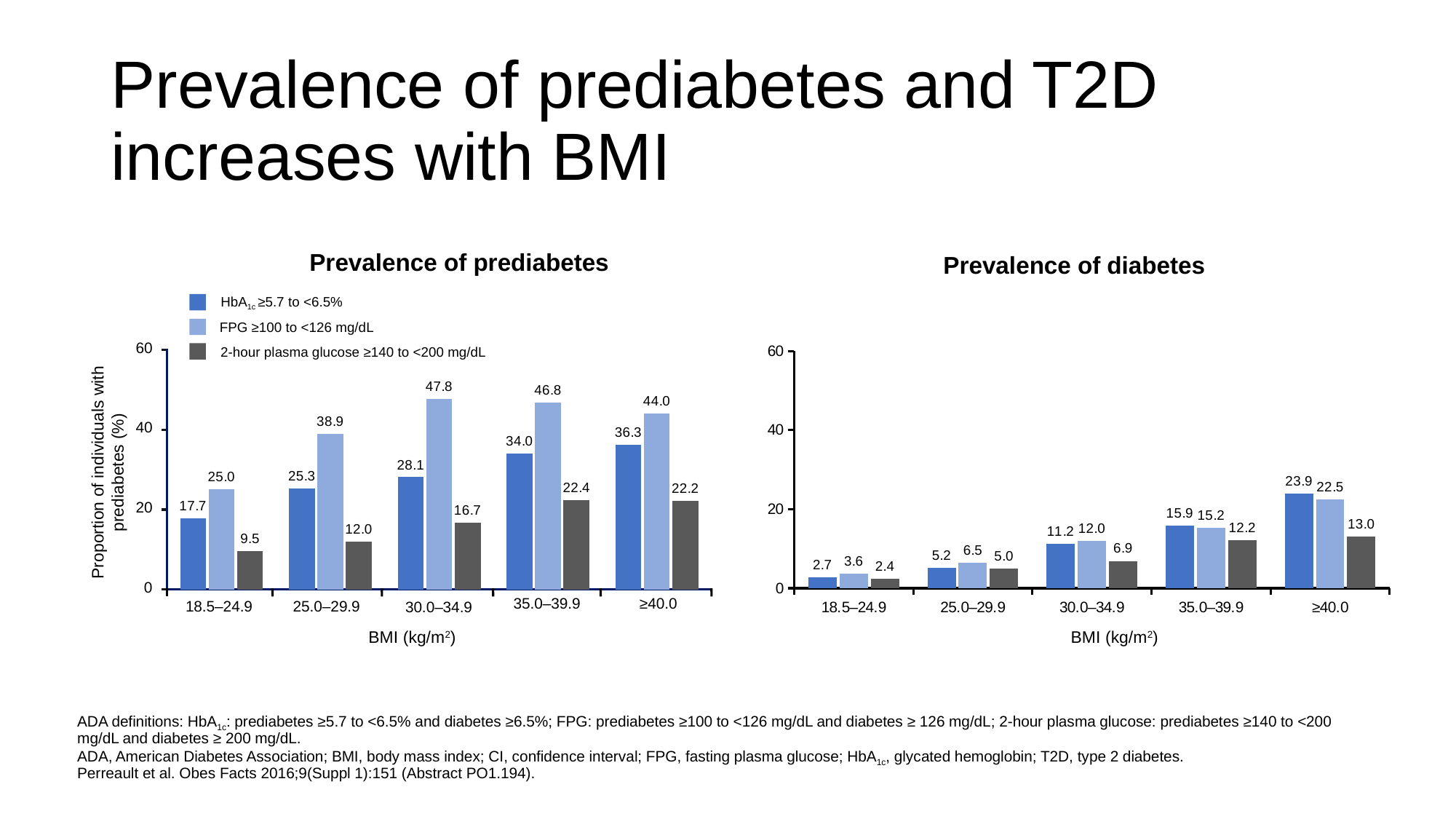
In the 'Prevalence of diabetes' chart, what is the value for HbA1c in the ≥40.0 BMI group? 23.9 In the 'Prevalence of diabetes' chart, is the 2-hour plasma glucose value for the 35.0–39.9 BMI group greater or less than 20? less What kind of chart is the 'Prevalence of prediabetes' chart? Bar chart In the 'Prevalence of prediabetes' chart, which BMI group has the highest value for the 2-hour plasma glucose series? 35.0–39.9 In the 'Prevalence of diabetes' chart, which BMI group has the lowest value for the FPG series? 18.5–24.9 How many BMI groups are shown on the x axis of the 'Prevalence of diabetes' chart? 5 In the 'Prevalence of diabetes' chart, what is the difference between the HbA1c value for ≥40.0 and the HbA1c value for 35.0–39.9? 8.0 How many series does the legend of the 'Prevalence of prediabetes' chart list? 3 In the 'Prevalence of prediabetes' chart, which is larger in the ≥40.0 BMI group: the HbA1c value or the FPG value? FPG In the 'Prevalence of prediabetes' chart, what is the value for FPG ≥100 to <126 mg/dL in the 30.0–34.9 BMI group? 47.8 In the 'Prevalence of prediabetes' chart, what is the difference between the FPG value and the HbA1c value in the 25.0–29.9 BMI group? 13.6 In the 'Prevalence of diabetes' chart, do the HbA1c values rise or fall as BMI increases along the x axis? Rise